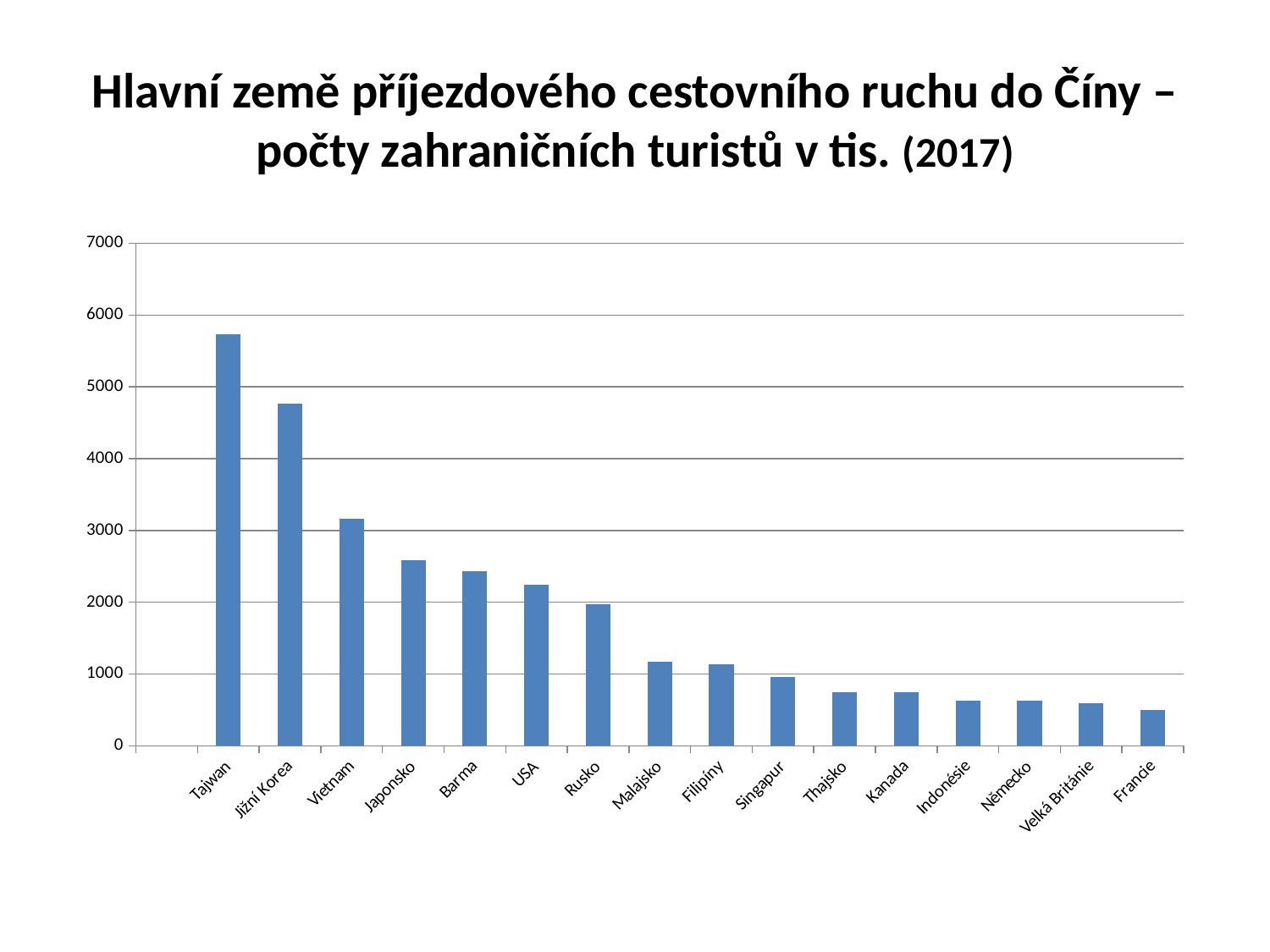
Which country has the lowest number of tourists in the chart? Francie Is the value for Tajwan greater or less than 5000? greater What kind of chart is shown on the slide? bar chart Which has a larger value, Vietnam or Japonsko? Vietnam Which country has the highest number of tourists in the chart? Tajwan Is the value for Malajsko greater or less than 1000? greater Is the value for Jižní Korea greater or less than 5000? less What year is given in the chart title? 2017 How many countries are shown on the x axis of the chart? 16 Do the values rise or fall from left to right along the x axis? fall